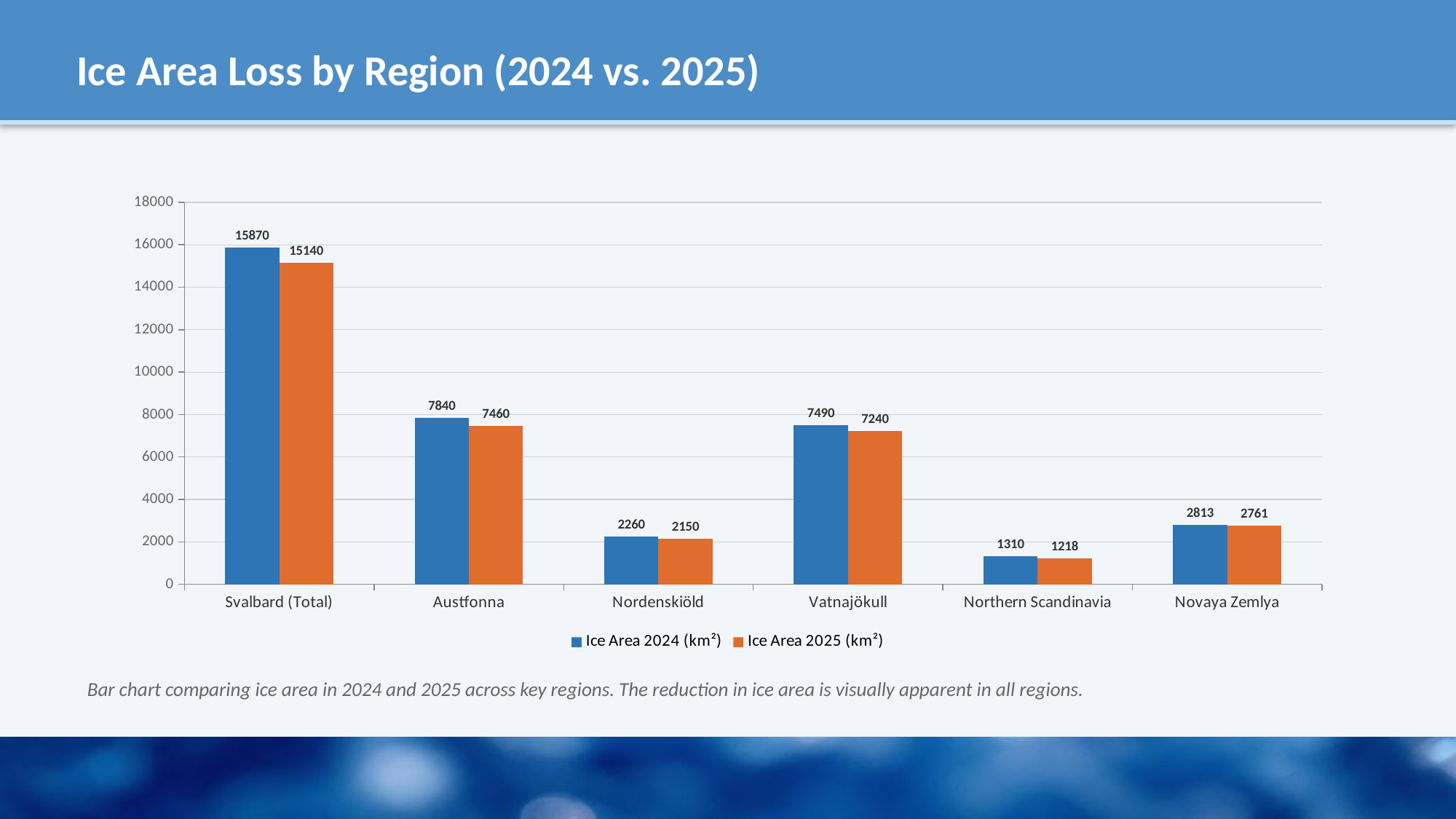
What is the Ice Area 2024 (km²) value for Svalbard (Total)? 15870 How many series does the legend list? 2 What is the Ice Area 2025 (km²) value for Northern Scandinavia? 1218 How many regions are shown on the x axis? 6 What kind of chart is shown on the slide? Bar chart What is the title of the slide? Ice Area Loss by Region (2024 vs. 2025) What is the difference between the Ice Area 2024 and Ice Area 2025 values for Svalbard (Total)? 730 What is the difference between the Ice Area 2024 and Ice Area 2025 values for Nordenskiöld? 110 Which region has the lowest Ice Area 2024 (km²) value? Northern Scandinavia What is the Ice Area 2025 (km²) value for Austfonna? 7460 Which region has the highest Ice Area 2025 (km²) value? Svalbard (Total) Which is larger: the Ice Area 2024 value for Austfonna or the Ice Area 2024 value for Vatnajökull? Austfonna